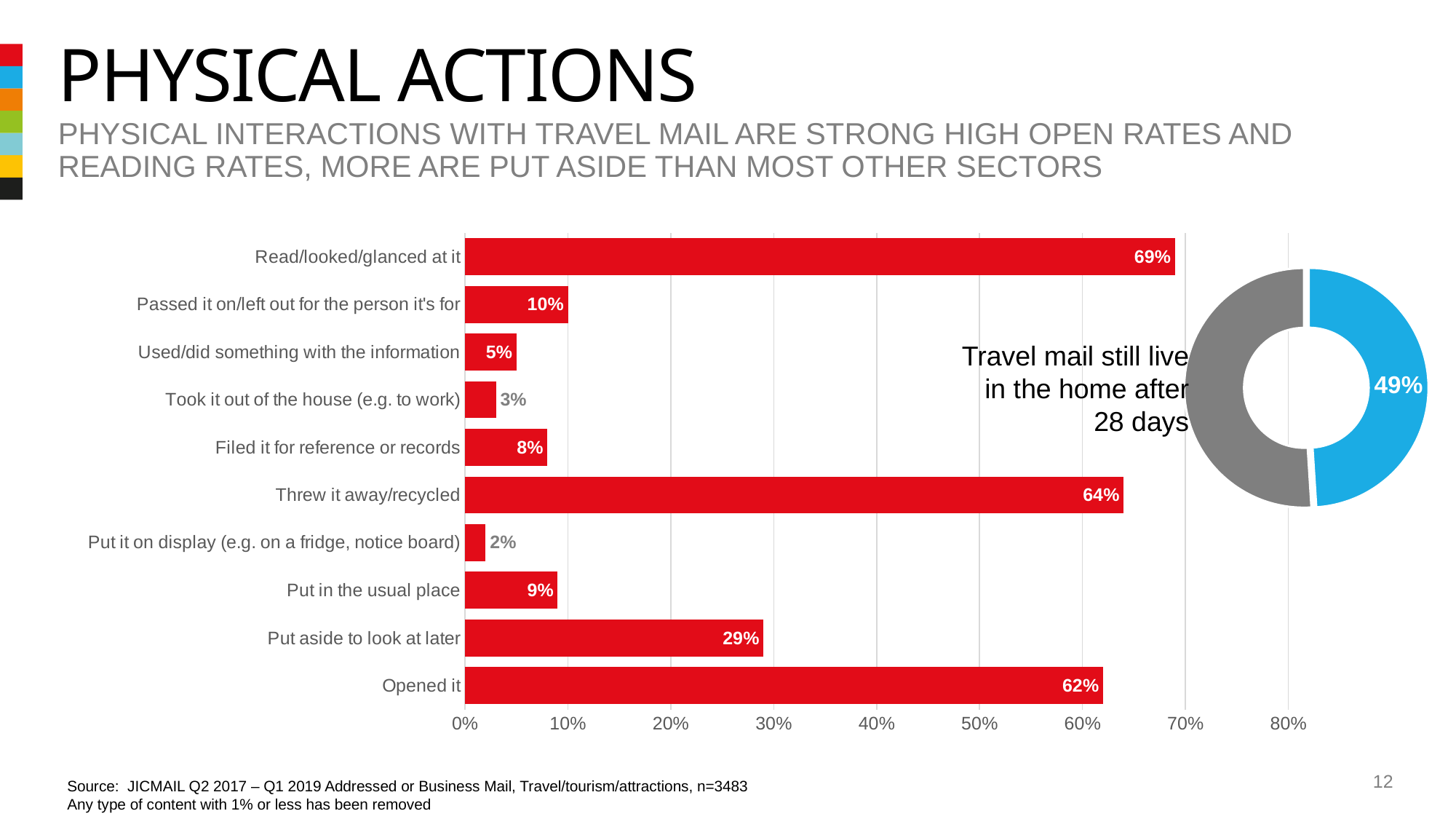
In the bar chart, which category has the lowest value? Put it on display (e.g. on a fridge, notice board) In the bar chart, what is the value for 'Read/looked/glanced at it'? 69% How many categories does the bar chart show? 10 In the bar chart, what is the value for 'Threw it away/recycled'? 64% What kind of chart is the chart on the left of the slide? Bar chart In the bar chart, what is the difference between 'Read/looked/glanced at it' and 'Opened it'? 7% In the bar chart, what is the value for 'Took it out of the house (e.g. to work)'? 3% In the bar chart, which is larger: 'Passed it on/left out for the person it's for' or 'Filed it for reference or records'? Passed it on/left out for the person it's for What kind of chart is the chart on the right of the slide? Doughnut chart In the doughnut chart, what share of travel mail is still live in the home after 28 days? 49% In the bar chart, what is the value for 'Put aside to look at later'? 29% In the bar chart, which category has the highest value? Read/looked/glanced at it